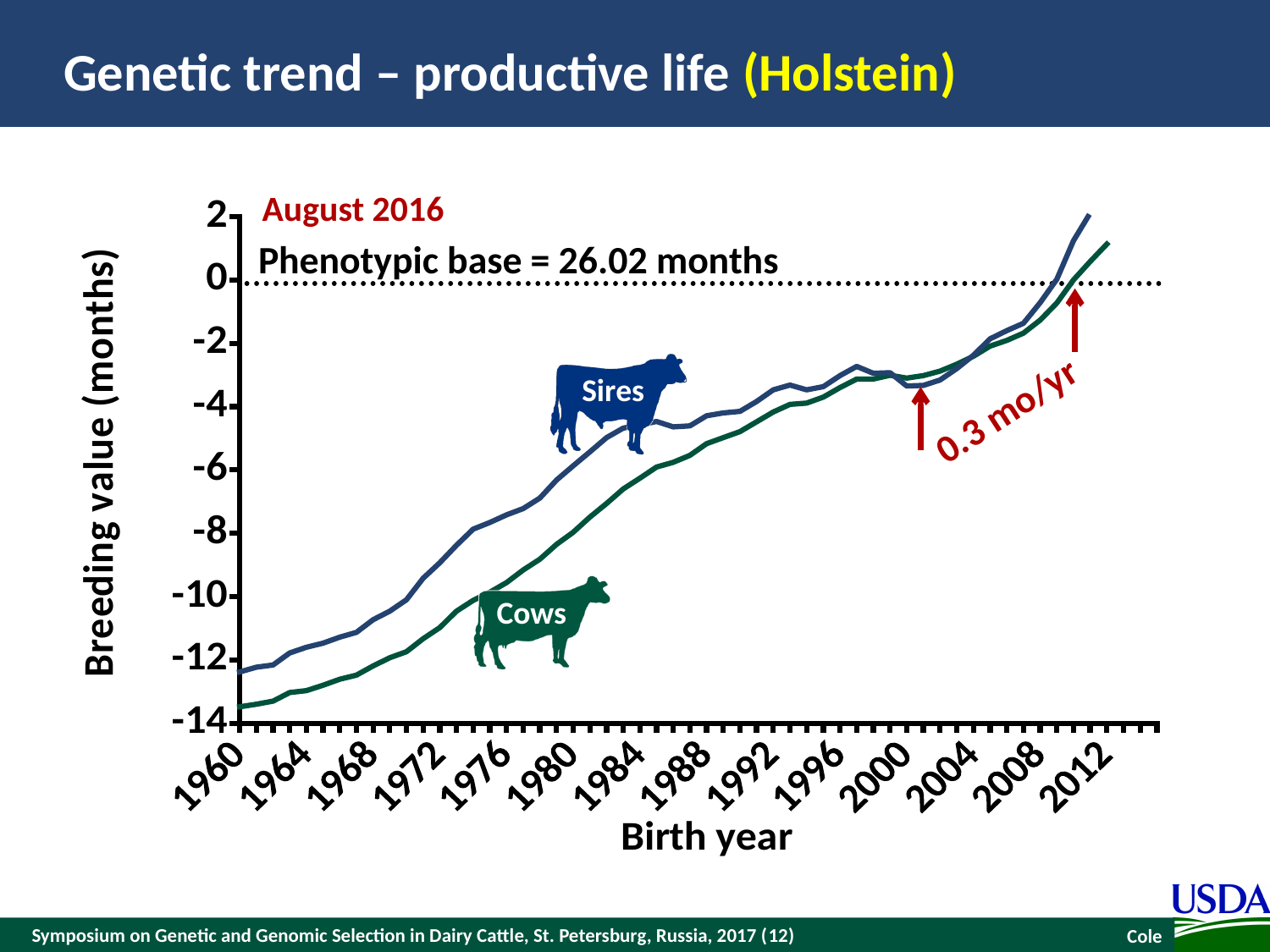
How many birth year labels are shown on the x axis? 14 Do the breeding values for Sires rise or fall as birth year increases from 1960 to 2012? rise Is the breeding value for Cows at birth year 1976 greater or less than -10? greater At birth year 1980, which series has the higher breeding value, Sires or Cows? Sires Is the breeding value for Sires at birth year 1960 greater or less than -12? less How many series are plotted on the chart? 2 What phenotypic base is stated on the chart? 26.02 months What kind of chart is shown on the slide? line chart Is the breeding value for Sires at birth year 2012 greater or less than 0? greater Do the breeding values for Cows rise or fall as birth year increases from 1960 to 2012? rise What are the names of the two series plotted on the chart? Sires and Cows